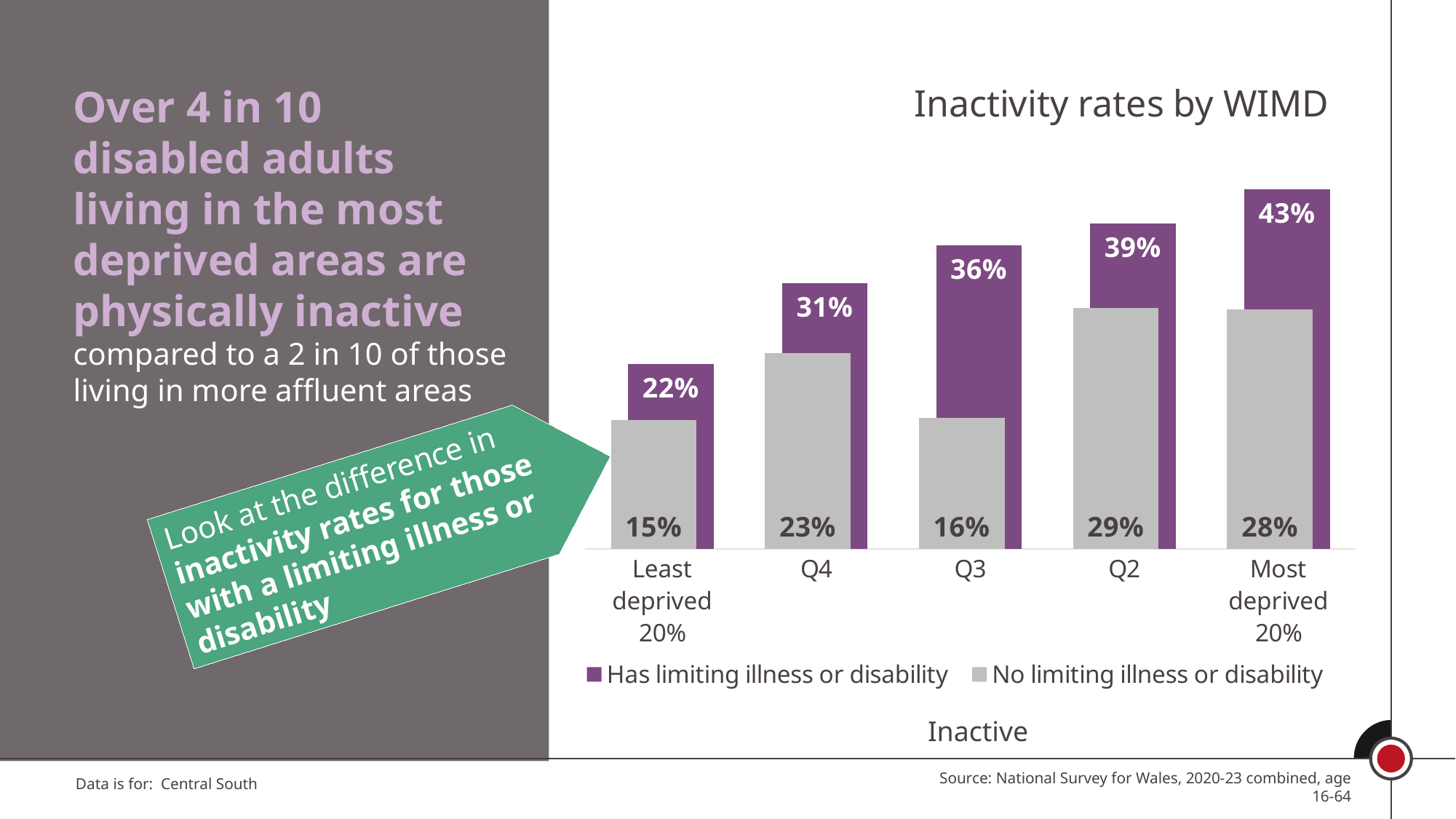
What is the title of the chart? Inactivity rates by WIMD What is the inactivity rate for those with no limiting illness or disability in Q3? 16% What is the inactivity rate for those with a limiting illness or disability in the Most deprived 20%? 43% How many WIMD categories are shown on the x axis? 5 Which category has the lowest inactivity rate for those with no limiting illness or disability? Least deprived 20% What is the difference between the inactivity rates for those with and without a limiting illness or disability in Q3? 20% How many series does the legend list? 2 Which is larger: the inactivity rate for those with no limiting illness or disability in Q2 or in the Most deprived 20%? Q2 What is the inactivity rate for those with a limiting illness or disability in the Least deprived 20%? 22% Do the inactivity rates for those with a limiting illness or disability rise or fall from Least deprived 20% to Most deprived 20%? Rise What kind of chart is shown on the slide? Bar chart Which category has the highest inactivity rate for those with a limiting illness or disability? Most deprived 20%